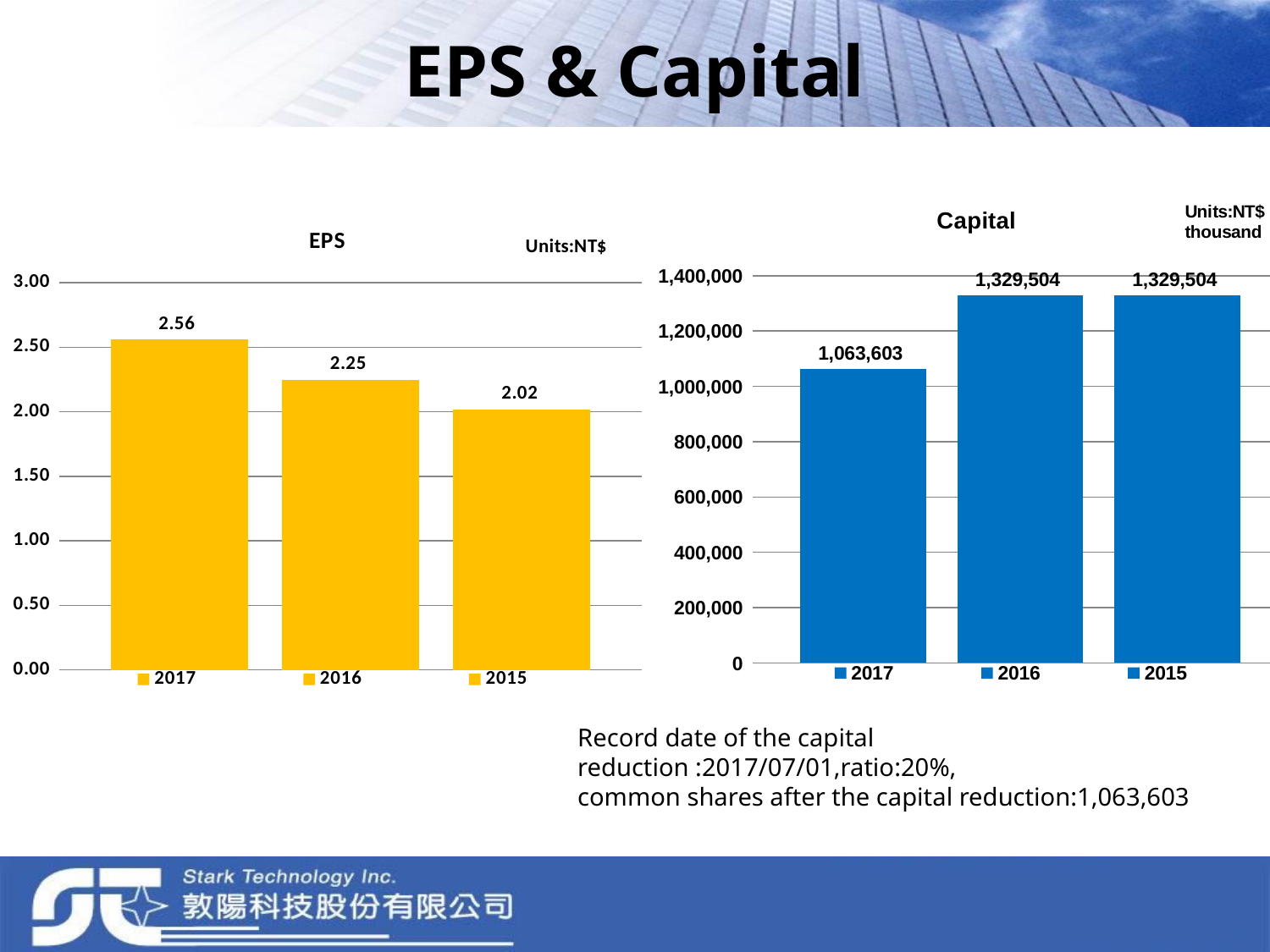
In the EPS chart, which year has the highest value? 2017 In the Capital chart, what is the value for 2016? 1,329,504 What type of chart is the EPS chart? bar chart In the EPS chart, what is the value for 2017? 2.56 In the EPS chart, what is the value for 2015? 2.02 In the EPS chart, which year has the lowest value? 2015 In the EPS chart, what is the difference between the 2017 and 2016 values? 0.31 In the Capital chart, what is the difference between the 2016 and 2017 values? 265,901 How many bars are in the Capital chart? 3 In the Capital chart, which year has the lowest value? 2017 In the EPS chart, is the value for 2016 greater or less than 2.00? greater In the Capital chart, what is the value for 2017? 1,063,603